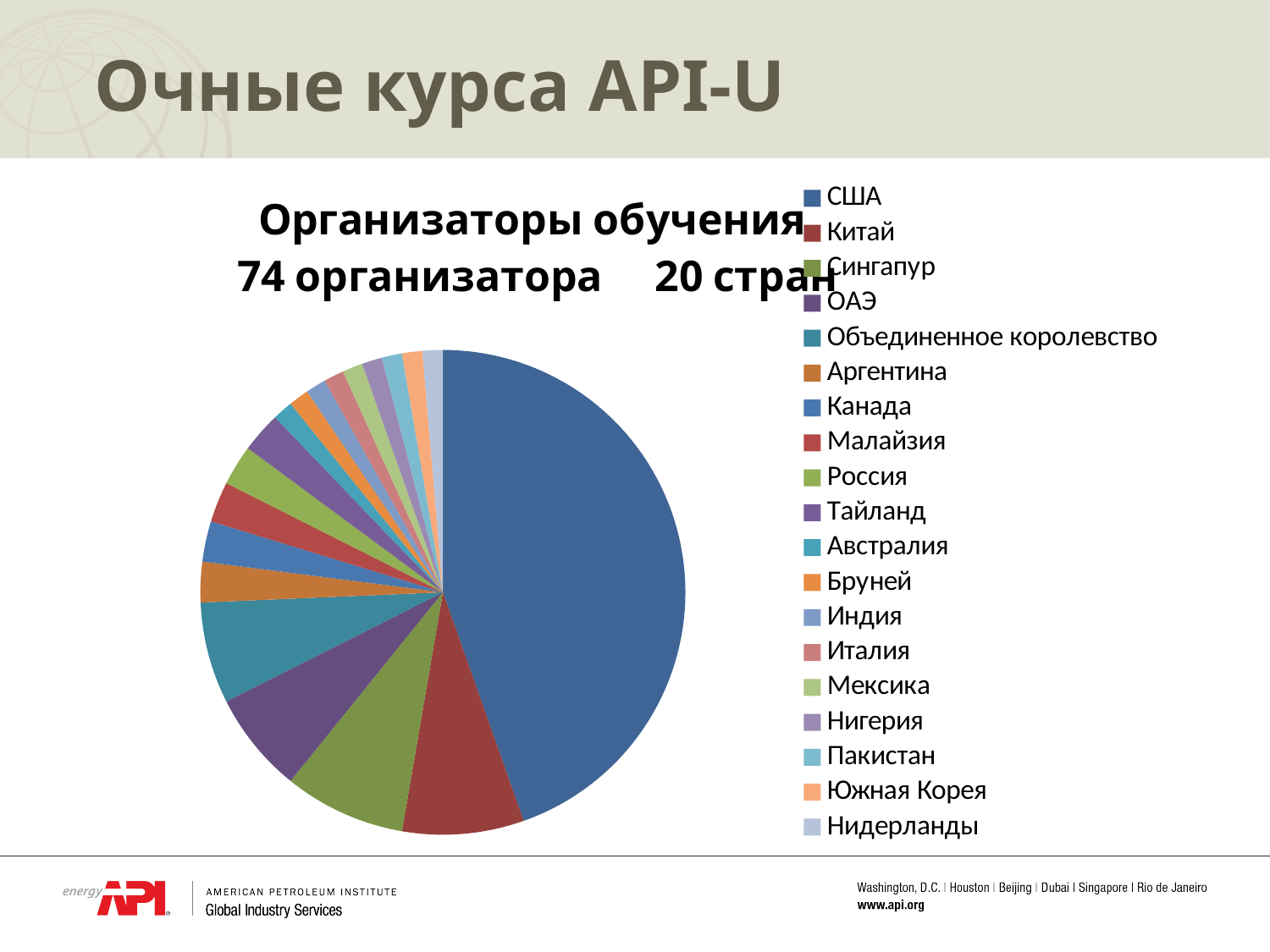
Which slice is larger in the pie chart, США or Нидерланды? США Which country has the largest slice in the pie chart? США What kind of chart is shown on the slide? pie chart How many countries does the chart title say are represented? 20 How many countries does the legend of the pie chart list? 19 Which slice is larger in the pie chart, Китай or Объединенное королевство? Китай Which country is listed first in the legend of the pie chart? США What is the title of the pie chart? Организаторы обучения 74 организатора 20 стран How many organizers does the chart title say there are? 74 Which slice is larger in the pie chart, США or Китай? США